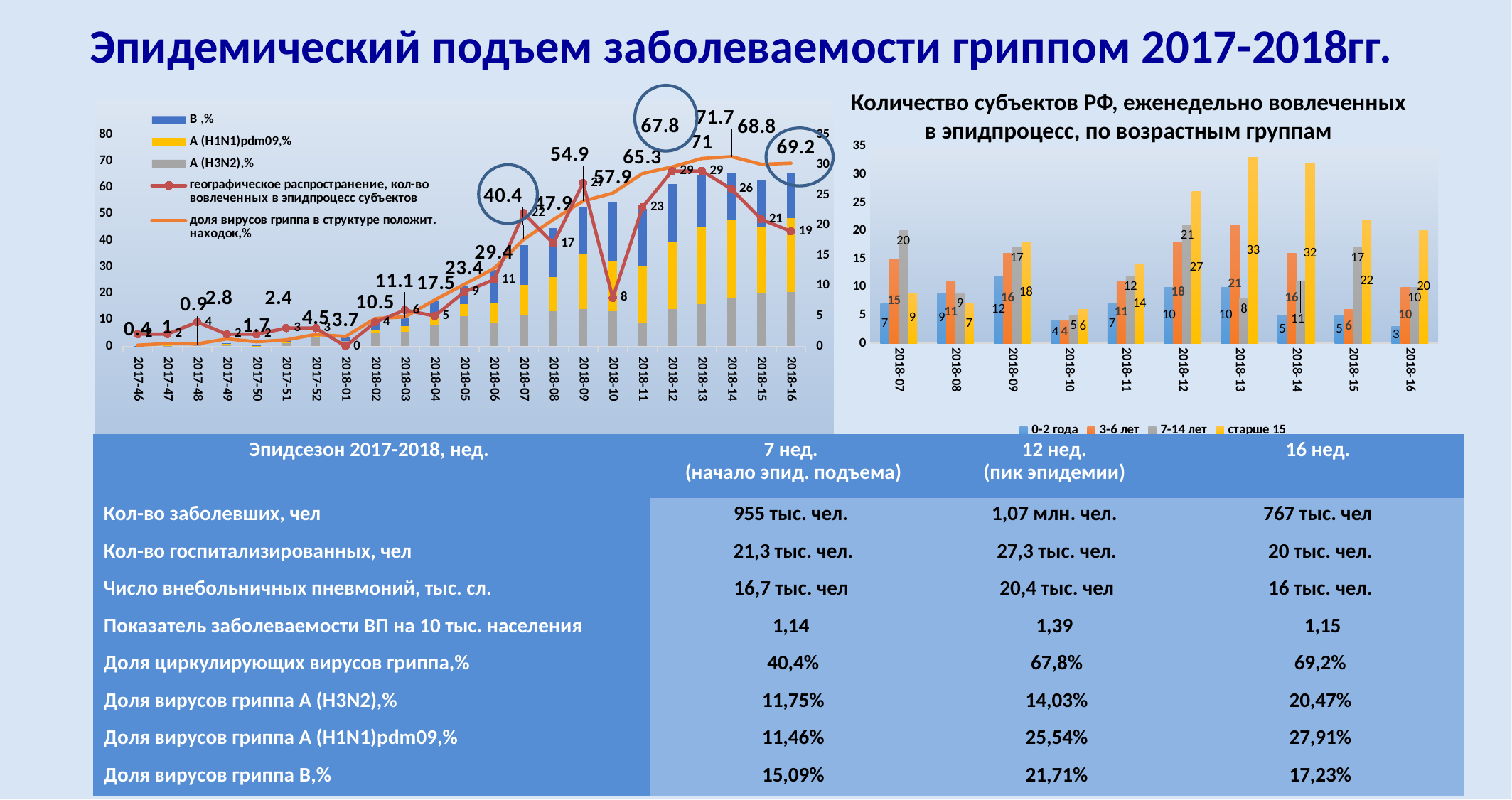
In the right-hand chart ('Количество субъектов РФ...'), what is the difference between 'старше 15' and '0-2 года' in week 2018-12? 17 In the left-hand chart, does the 'доля вирусов гриппа в структуре положит. находок,%' line rise or fall from 2017-46 to 2018-14? rise In the right-hand chart ('Количество субъектов РФ...'), what is the value for '0-2 года' in week 2018-09? 12 How many series does the legend of the right-hand chart ('Количество субъектов РФ...') list? 4 How many series does the legend of the left-hand chart list? 5 In the right-hand chart ('Количество субъектов РФ...'), in which week is the '0-2 года' series lowest? 2018-16 In the right-hand chart ('Количество субъектов РФ...'), what is the value for 'старше 15' in week 2018-13? 33 In the right-hand chart ('Количество субъектов РФ...'), in which week is the 'старше 15' series highest? 2018-13 In the left-hand chart, what is the value of 'доля вирусов гриппа в структуре положит. находок,%' for week 2018-14? 71.7 In the right-hand chart ('Количество субъектов РФ...'), which is larger in week 2018-07: '7-14 лет' or '3-6 лет'? 7-14 лет What kind of chart is the chart titled 'Количество субъектов РФ, еженедельно вовлеченных в эпидпроцесс, по возрастным группам'? bar chart How many week categories are shown on the x axis of the right-hand chart ('Количество субъектов РФ...')? 10